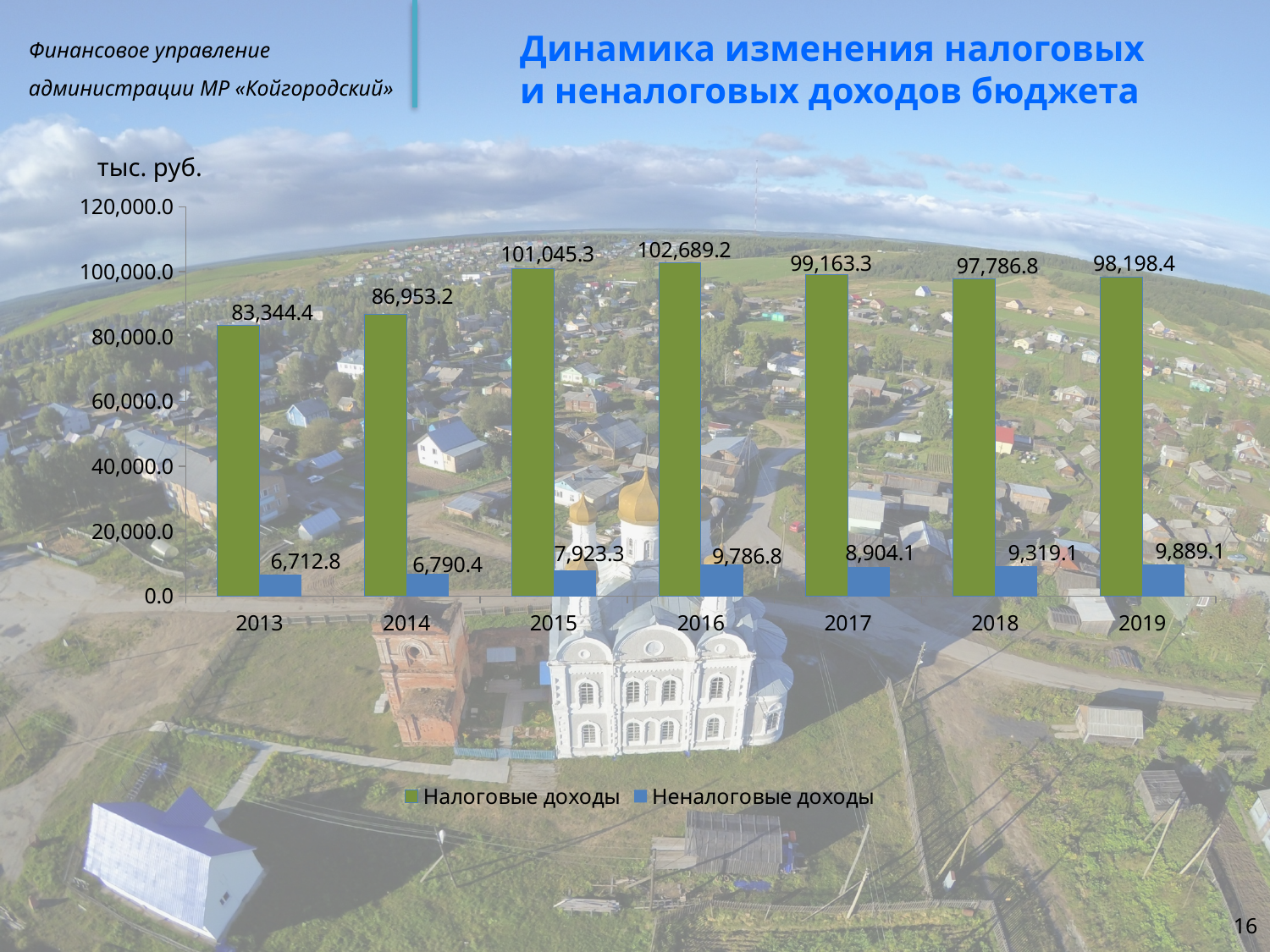
In which year are Неналоговые доходы the lowest? 2013 In which year are Налоговые доходы the highest? 2016 What type of chart is shown on the slide? bar chart What is the value of Неналоговые доходы for 2013? 6,712.8 How many series does the legend list? 2 What is the difference between Налоговые доходы in 2016 and in 2013? 19,344.8 What unit is indicated above the vertical axis of the chart? тыс. руб. What is the value of Налоговые доходы for 2016? 102,689.2 How many years are shown on the x axis? 7 Which is larger: Налоговые доходы in 2015 or in 2017? 2015 What is the difference between Неналоговые доходы in 2019 and in 2013? 3,176.3 What is the value of Налоговые доходы for 2019? 98,198.4